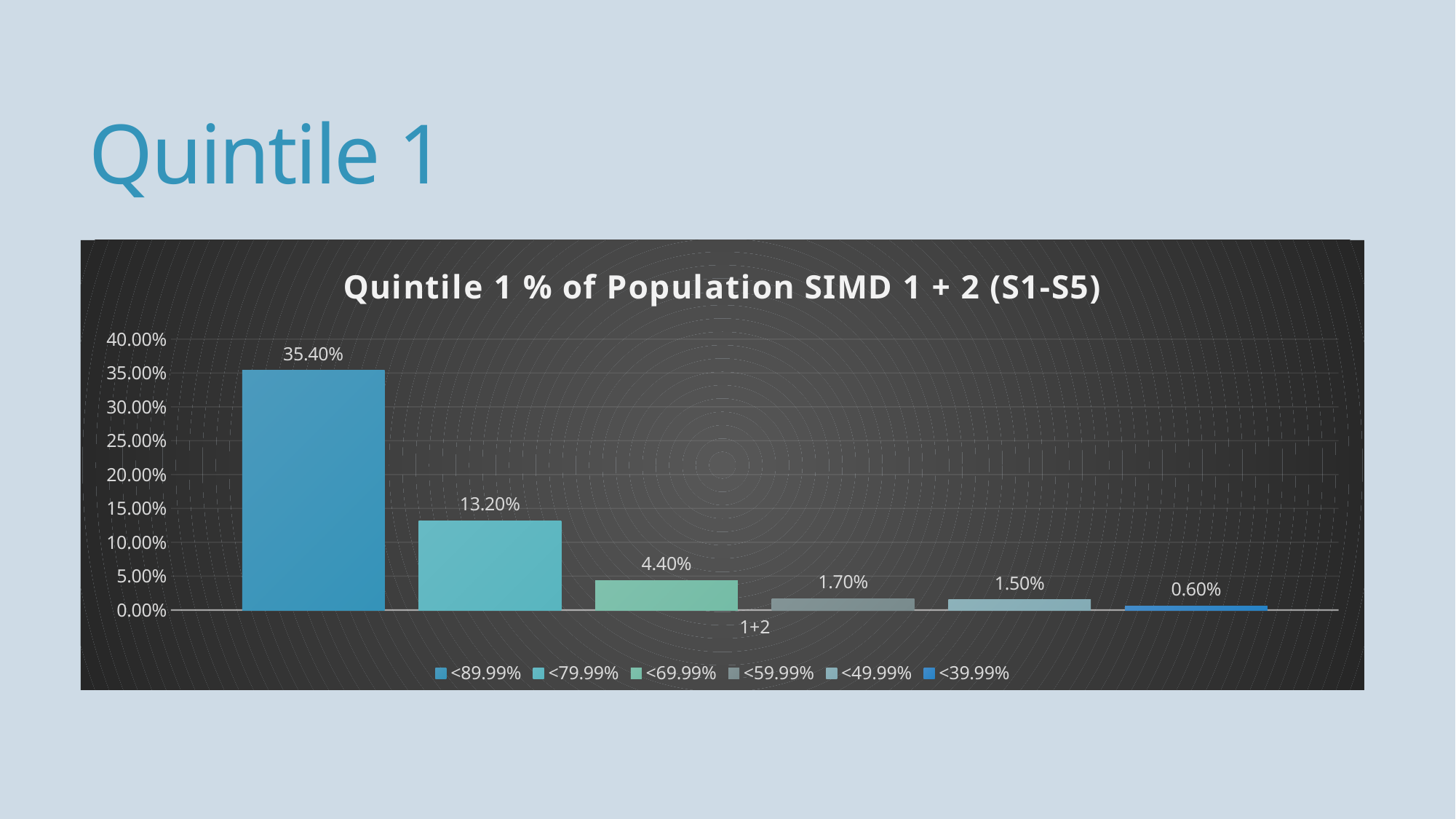
What kind of chart is shown? bar chart What is the value for the <69.99% series? 4.40% How many series does the legend list? 6 Which series has the lowest value? <39.99% Is the value for <79.99% greater or less than 10.00%? greater What is the value for the <89.99% series? 35.40% What is the value for the <79.99% series? 13.20% Which is larger, the value for <59.99% or the value for <49.99%? <59.99% What is the difference between the <89.99% and <79.99% values? 22.20% Which series has the highest value? <89.99% What is the value for the <39.99% series? 0.60% What is the title of the chart? Quintile 1 % of Population SIMD 1 + 2 (S1-S5)